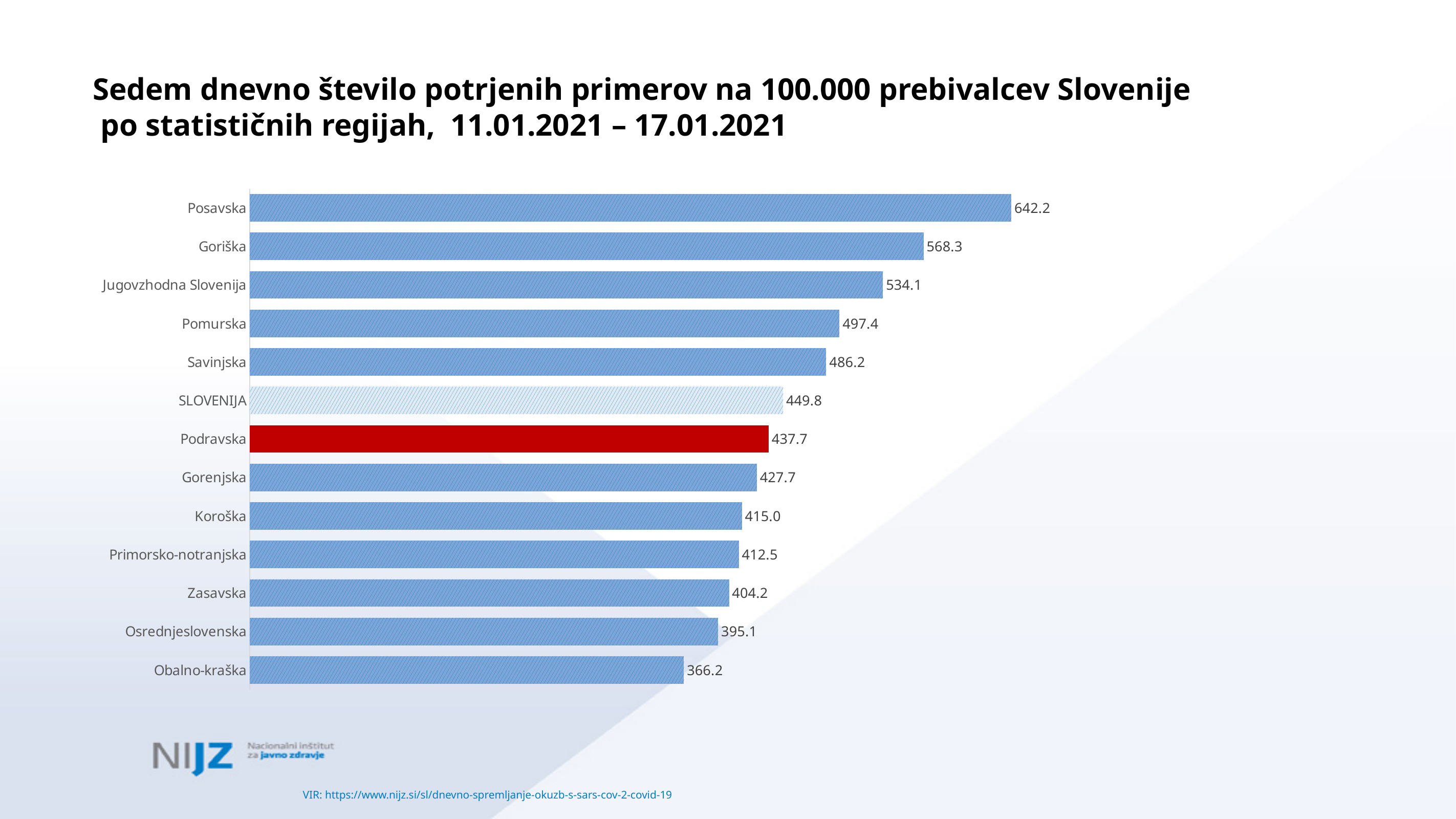
What is the difference between the values for SLOVENIJA and Podravska? 12.1 What is the value for Obalno-kraška? 366.2 How many bars are shown in the chart? 13 What kind of chart is shown on the slide? Bar chart What is the value for Podravska? 437.7 Which category has the lowest value? Obalno-kraška What is the value for Posavska? 642.2 Which bar is coloured red? Podravska What is the value for SLOVENIJA? 449.8 Which is larger, the value for Pomurska or the value for Savinjska? Pomurska What is the difference between the values for Posavska and Goriška? 73.9 Which category has the highest value? Posavska